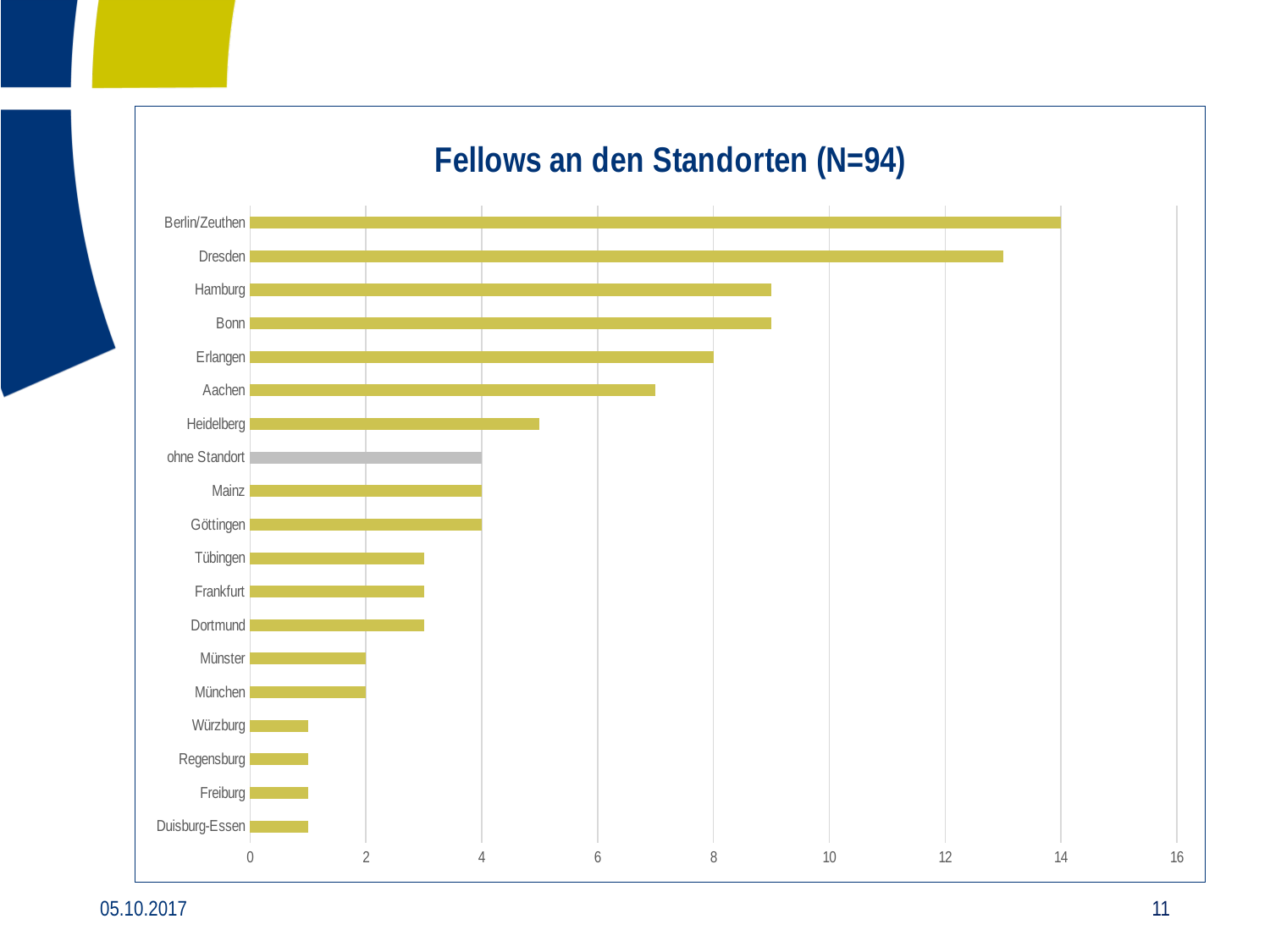
How many fellows are shown for Erlangen? 8 Is the value for Dresden greater or less than 12? greater How many categories are shown on the chart? 19 How many fellows are shown for München? 2 Is the value for Aachen greater or less than 8? less Which location has the highest number of fellows? Berlin/Zeuthen How many fellows are shown for Berlin/Zeuthen? 14 What is the title of the chart? Fellows an den Standorten (N=94) Which has more fellows, Dresden or Hamburg? Dresden What kind of chart is shown on the slide? bar chart What is the difference between the values for Berlin/Zeuthen and Erlangen? 6 How many fellows are shown for Mainz? 4